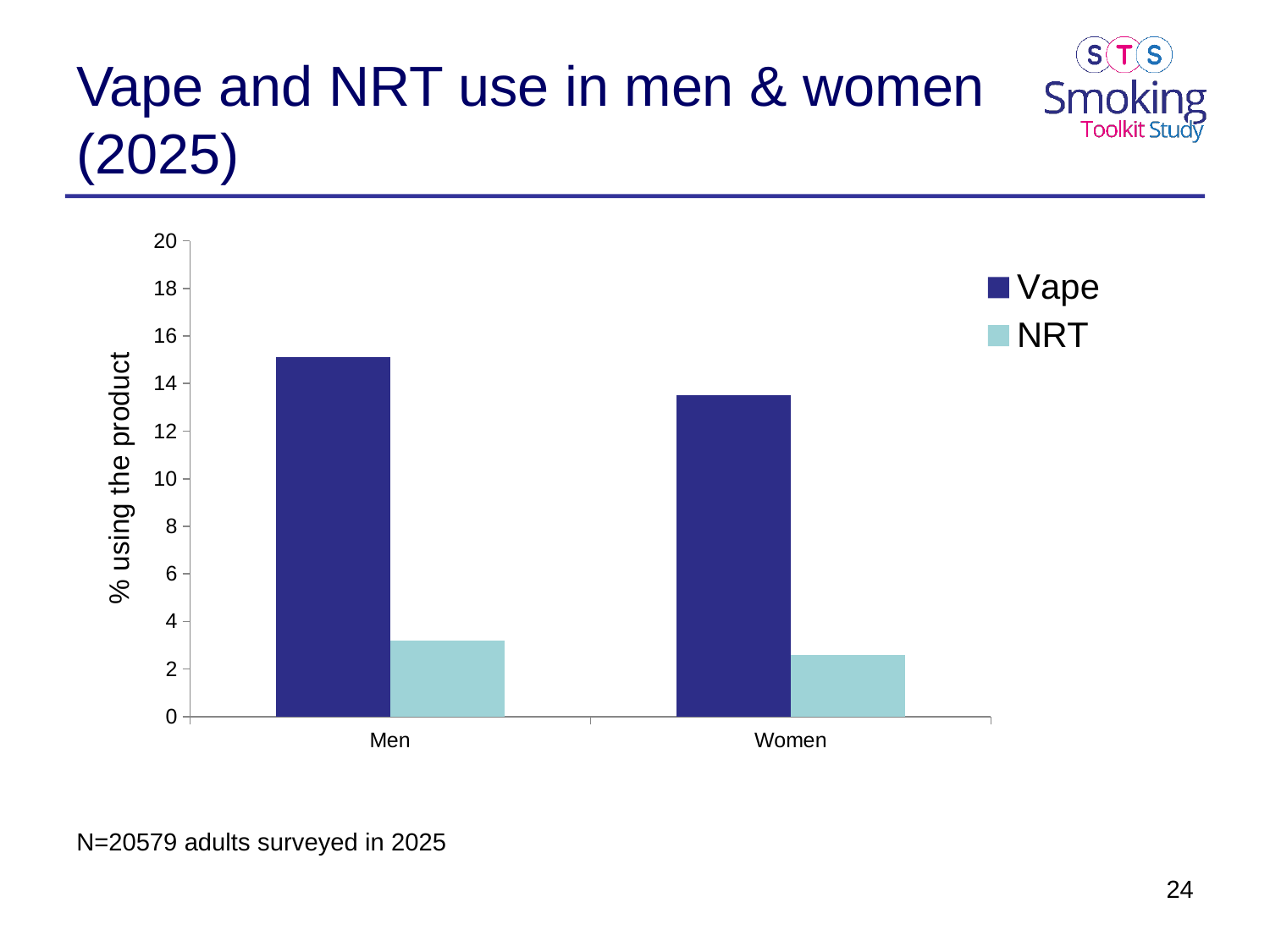
How many categories are shown on the x axis? 2 Which group has the higher Vape value, Men or Women? Men Is the Vape value for Women greater or less than 14? less What is the label on the y axis? % using the product For Men, which is larger, the Vape value or the NRT value? Vape Is the Vape value for Men greater or less than 14? greater How many series does the legend list? 2 What kind of chart is shown on the slide? bar chart Which series is shown in dark blue? Vape Is the Vape value for Women greater or less than 12? greater